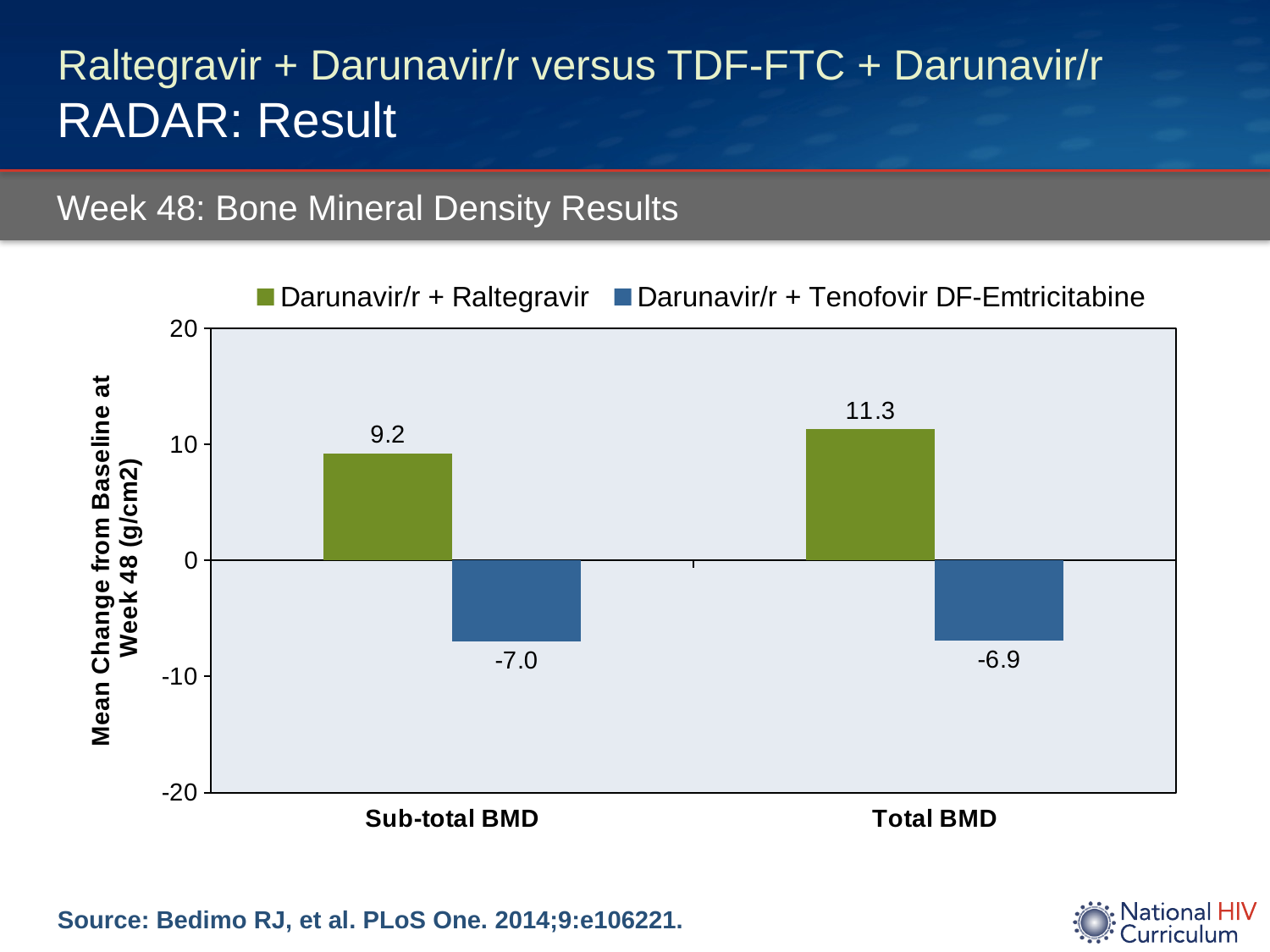
How many categories are shown on the x axis? 2 Which bar shows the highest value on the chart? Darunavir/r + Raltegravir, Total BMD What is the difference between the Darunavir/r + Raltegravir values for Total BMD and Sub-total BMD? 2.1 What kind of chart is shown on the slide? bar chart Is the Darunavir/r + Raltegravir value for Total BMD greater or less than 10? greater Which bar shows the lowest value on the chart? Darunavir/r + Tenofovir DF-Emtricitabine, Sub-total BMD What is the mean change from baseline for Darunavir/r + Raltegravir in Total BMD? 11.3 Which is larger for Sub-total BMD: the Darunavir/r + Raltegravir value or the Darunavir/r + Tenofovir DF-Emtricitabine value? Darunavir/r + Raltegravir What is the mean change from baseline for Darunavir/r + Raltegravir in Sub-total BMD? 9.2 What is the mean change from baseline for Darunavir/r + Tenofovir DF-Emtricitabine in Sub-total BMD? -7.0 How many series does the legend list? 2 What is the mean change from baseline for Darunavir/r + Tenofovir DF-Emtricitabine in Total BMD? -6.9